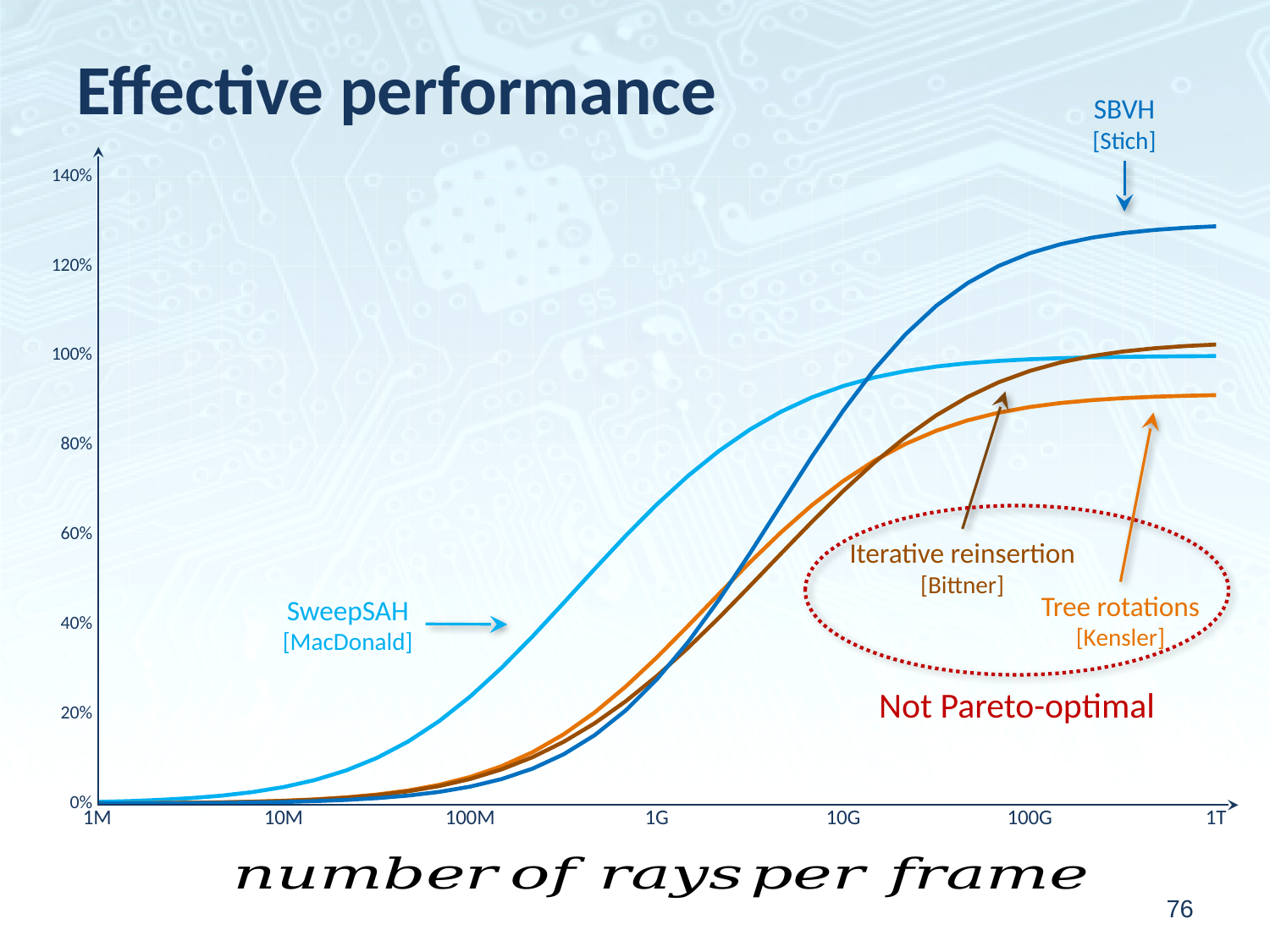
Is the value of the SweepSAH curve at 10G greater or less than 80%? greater What kind of chart is shown on the slide? line chart What is the title of the chart? Effective performance Which two curves are circled and labelled as 'Not Pareto-optimal'? Iterative reinsertion [Bittner] and Tree rotations [Kensler] Which curve is highest at 100M rays per frame? SweepSAH [MacDonald] Is the value of the SBVH curve at 1T greater or less than 120%? greater Is the value of the Tree rotations curve at 1T greater or less than 100%? less Which curve is lowest at 1T rays per frame? Tree rotations [Kensler] At 100M rays per frame, which curve is higher, SweepSAH or SBVH? SweepSAH How many curves are plotted on the chart? 4 Which curve is highest at 1T rays per frame? SBVH [Stich] Do the curves rise or fall as the number of rays per frame increases? rise